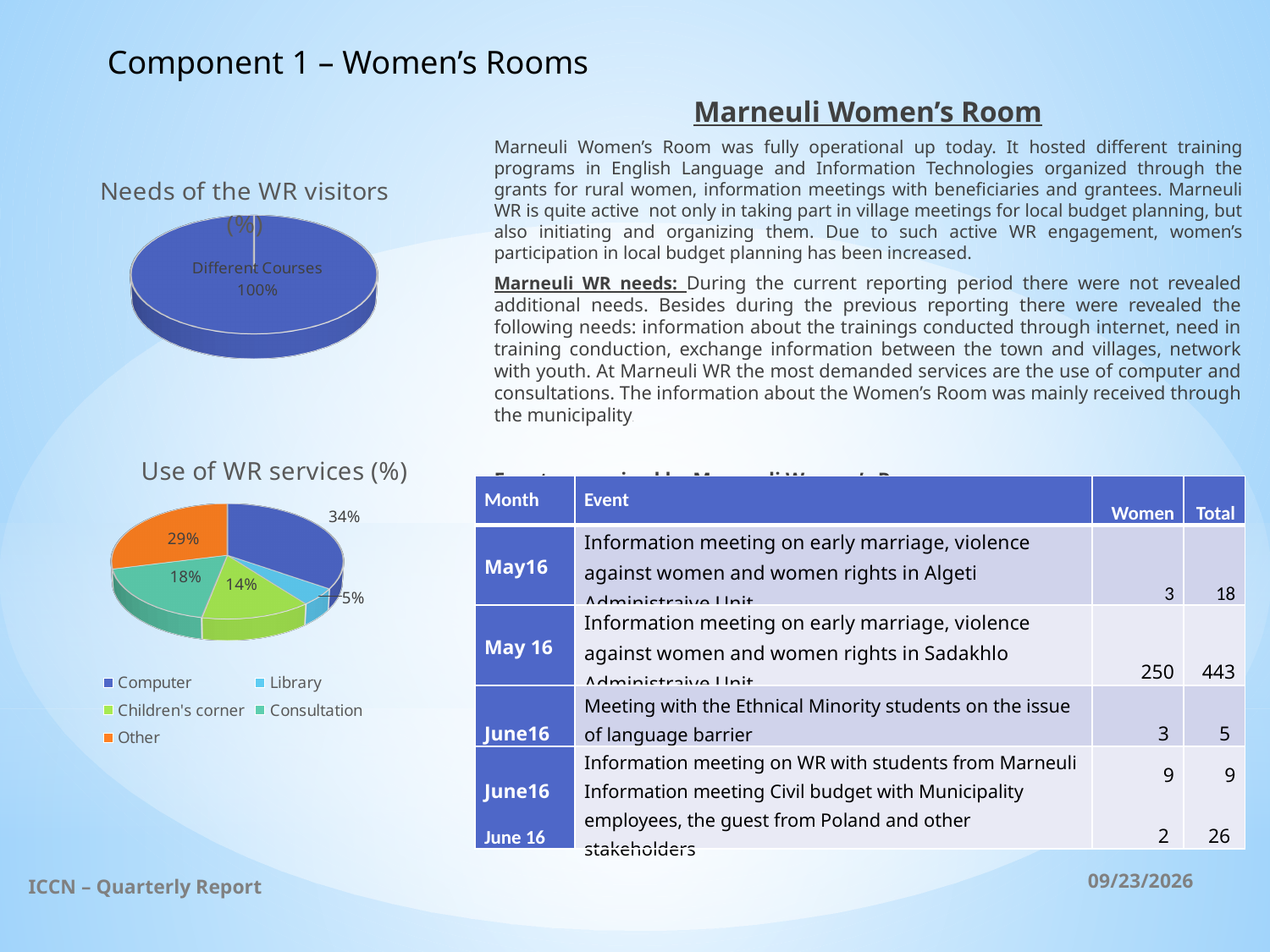
In the 'Use of WR services (%)' chart, which is larger: Consultation or Children's corner? Consultation In the 'Use of WR services (%)' chart, what percentage is shown for Library? 5% In the 'Use of WR services (%)' chart, which colour represents Other? Orange In the 'Use of WR services (%)' chart, which service has the largest share? Computer In the 'Use of WR services (%)' chart, what is the difference between the Computer share and the Children's corner share? 20% In the 'Use of WR services (%)' chart, what percentage is shown for Other? 29% How many categories does the legend of the 'Use of WR services (%)' chart list? 5 In the 'Needs of the WR visitors (%)' chart, what percentage is shown for Different Courses? 100% In the 'Use of WR services (%)' chart, what percentage is shown for Consultation? 18% In the 'Use of WR services (%)' chart, what percentage is shown for Computer? 34% In the 'Use of WR services (%)' chart, which service has the smallest share? Library What kind of chart is 'Needs of the WR visitors (%)'? Pie chart